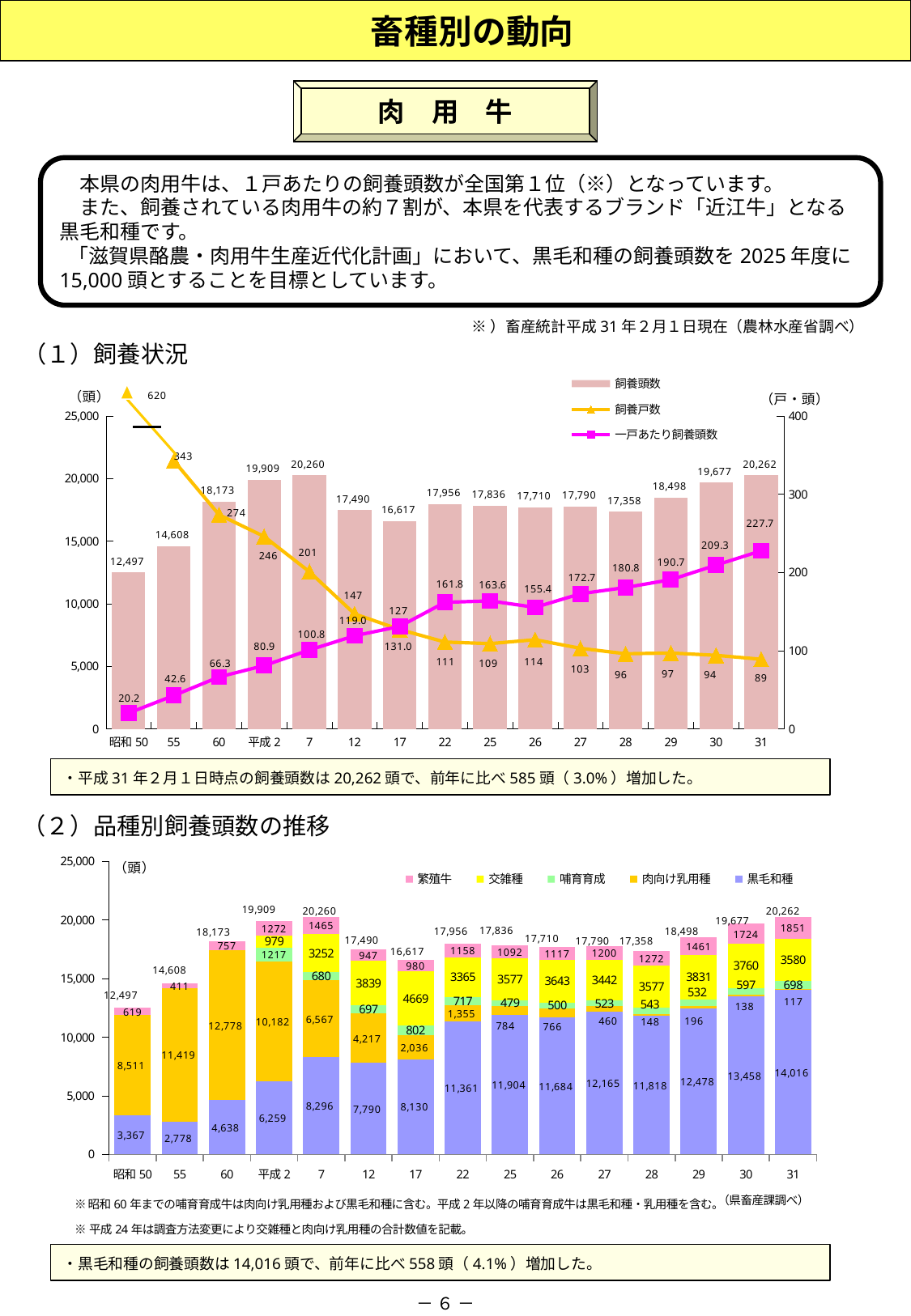
In the (1) 飼養状況 chart, what is the 飼養頭数 value for 31 (平成31)? 20,262 In the (2) 品種別飼養頭数の推移 chart, what is the total of the stacked bar for 31? 20,262 In the (1) 飼養状況 chart, what is the 飼養戸数 value for 昭和50? 620 In the (1) 飼養状況 chart, what is the difference in 飼養頭数 between 31 and 30? 585 How many series does the legend of the (1) 飼養状況 chart list? 3 In the (2) 品種別飼養頭数の推移 chart, what is the 黒毛和種 value for 31? 14,016 In the (1) 飼養状況 chart, which year has the highest 一戸あたり飼養頭数? 31 How many series does the legend of the (2) 品種別飼養頭数の推移 chart list? 5 In the (2) 品種別飼養頭数の推移 chart, which is larger, the 黒毛和種 value for 30 or for 31? 31 In the (1) 飼養状況 chart, which year has the lowest 飼養頭数? 昭和50 In the (1) 飼養状況 chart, how many years are shown on the x axis? 15 In the (1) 飼養状況 chart, does the 飼養戸数 line rise or fall from 昭和50 to 31? fall